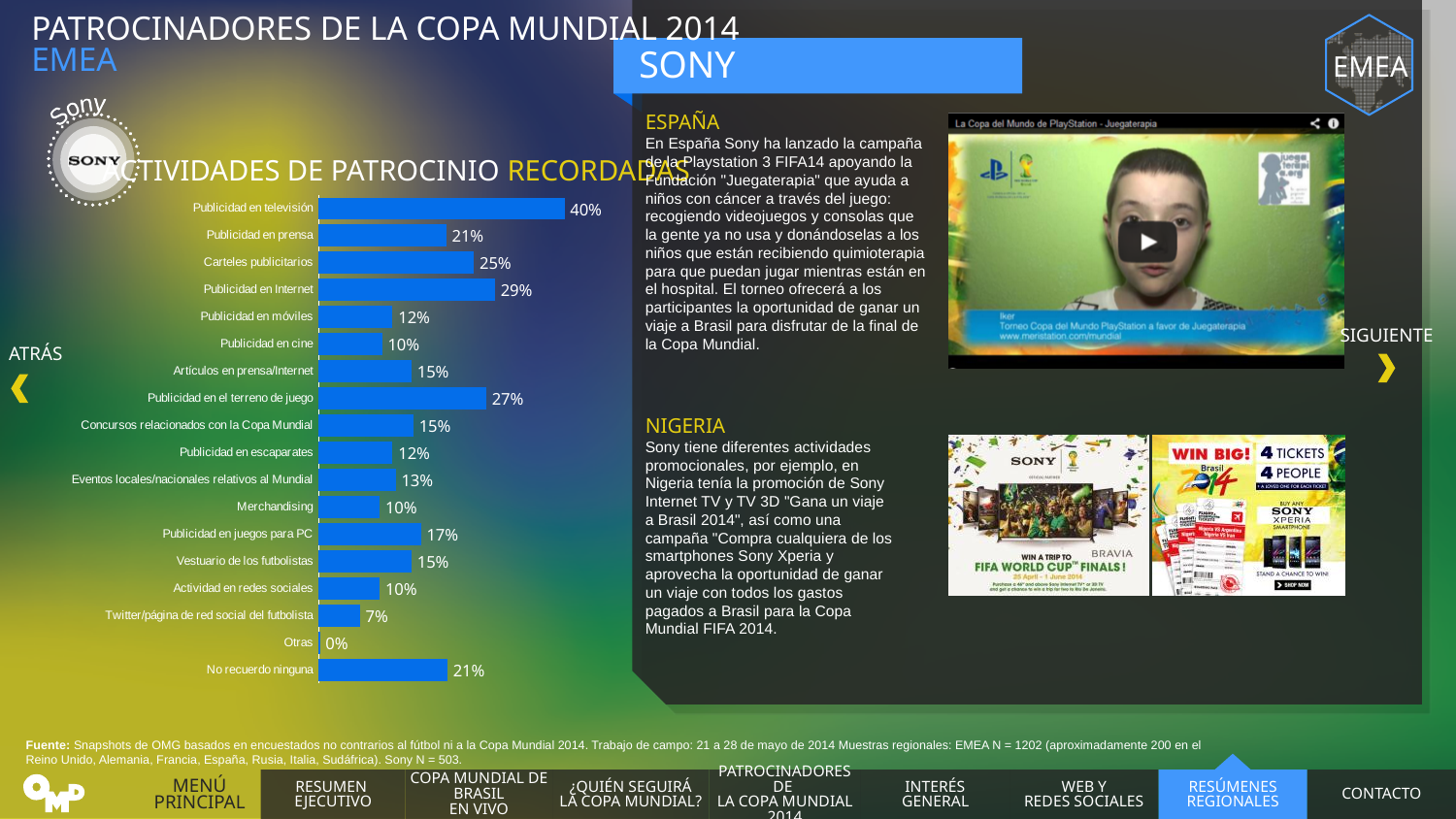
Which category has the lowest value? Otras What is the difference between Publicidad en juegos para PC and Publicidad en móviles? 5% How many categories are shown in the bar chart? 18 What is the title of the chart? ACTIVIDADES DE PATROCINIO RECORDADAS What kind of chart is shown on the slide? Bar chart Which category has the highest value? Publicidad en televisión What value is shown for Publicidad en Internet? 29% What is the difference between Publicidad en televisión and Publicidad en Internet? 11% What value is shown for Twitter/página de red social del futbolista? 7% What value is shown for No recuerdo ninguna? 21% Which is larger, Carteles publicitarios or Publicidad en el terreno de juego? Publicidad en el terreno de juego What value is shown for Publicidad en televisión? 40%